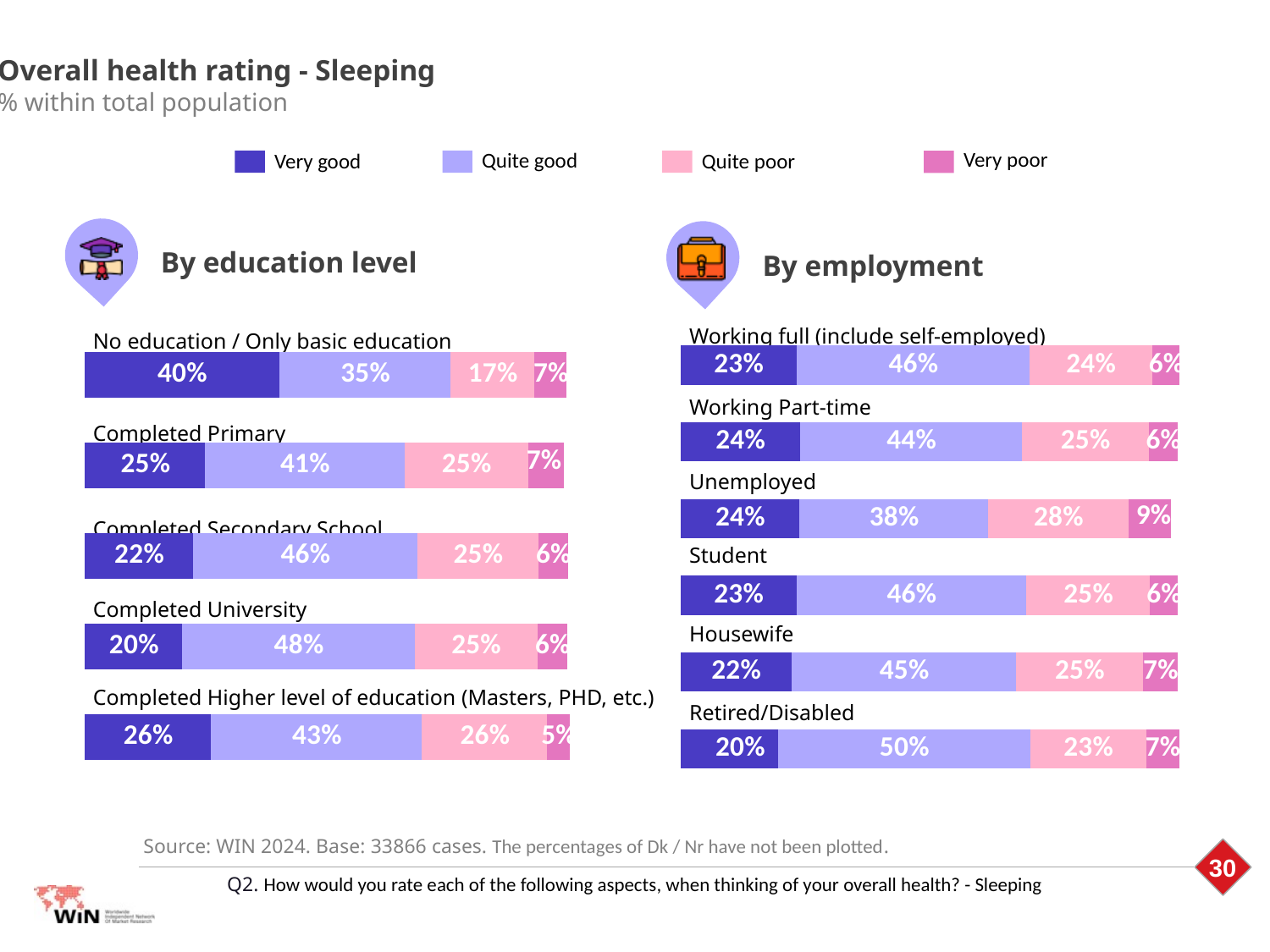
How many categories are shown in the 'By education level' chart? 5 In the 'By education level' chart, what is the 'Very good' value for No education / Only basic education? 40% How many series does the legend list? 4 In the 'By education level' chart, what is the combined 'Very good' and 'Quite good' value for Completed Higher level of education (Masters, PHD, etc.)? 69% In the 'By education level' chart, which category has the highest 'Very good' value? No education / Only basic education In the 'By employment' chart, which is larger: the 'Quite poor' value for Unemployed or for Working full (include self-employed)? Unemployed In the 'By education level' chart, what is the difference between the 'Quite good' values for Completed University and No education / Only basic education? 13% In the 'By employment' chart, which category has the lowest 'Quite good' value? Unemployed How many categories are shown in the 'By employment' chart? 6 What kind of chart is used in the 'By education level' section? Stacked bar chart In the 'By employment' chart, what is the 'Very poor' value for Unemployed? 9% In the 'By employment' chart, what is the 'Quite good' value for Retired/Disabled? 50%